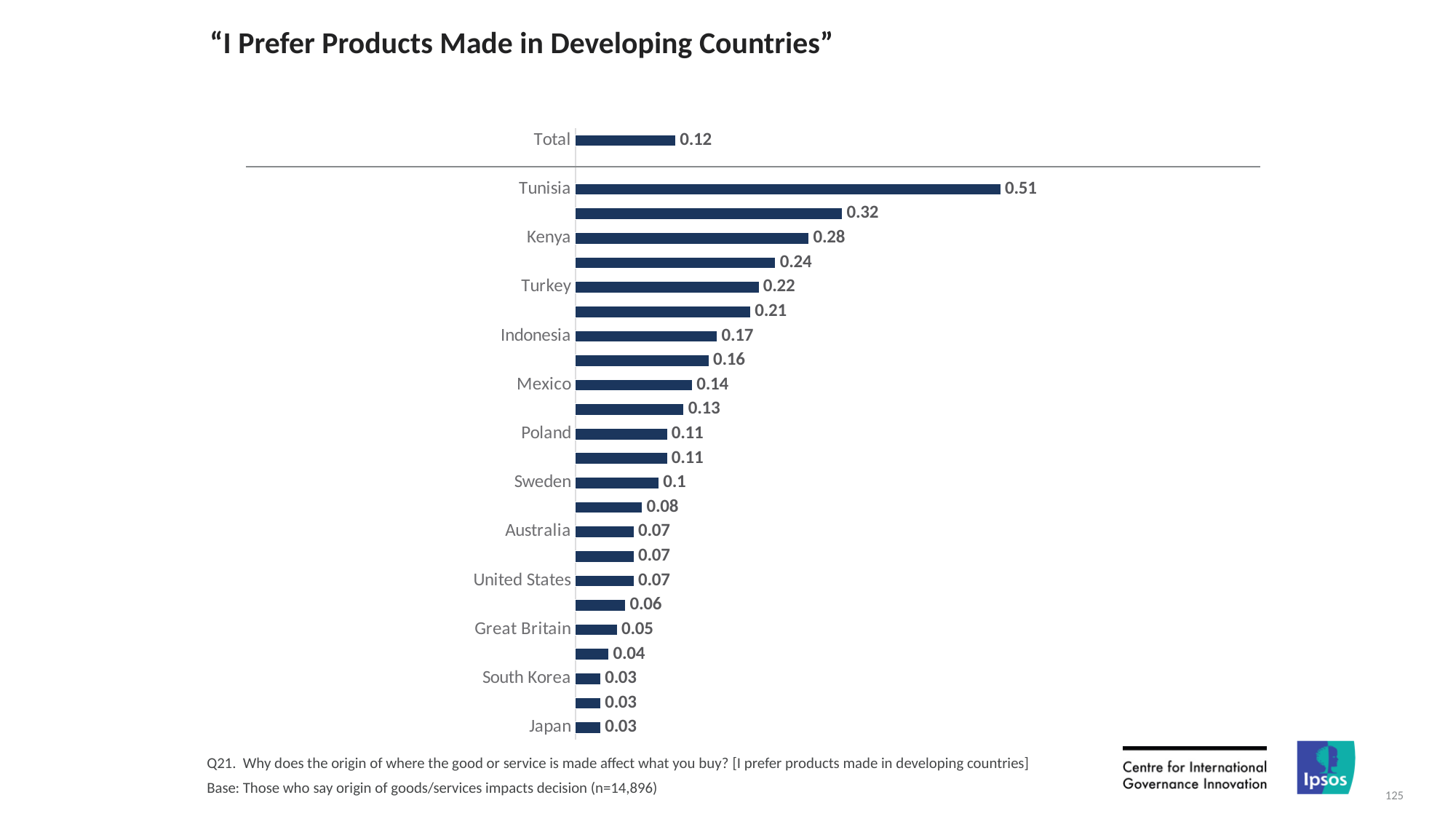
What is the difference between the values for Turkey and Indonesia? 0.05 What is the value for Total? 0.12 What is the value for Japan? 0.03 What is the value for Sweden? 0.1 What is the difference between the values for Tunisia and Kenya? 0.23 Which has a larger value, Mexico or Great Britain? Mexico What is the title of the chart? "I Prefer Products Made in Developing Countries" What is the value for Tunisia? 0.51 Which country has the highest value? Tunisia What kind of chart is shown on the slide? Bar chart What is the value for Kenya? 0.28 Which has a larger value, Kenya or Turkey? Kenya